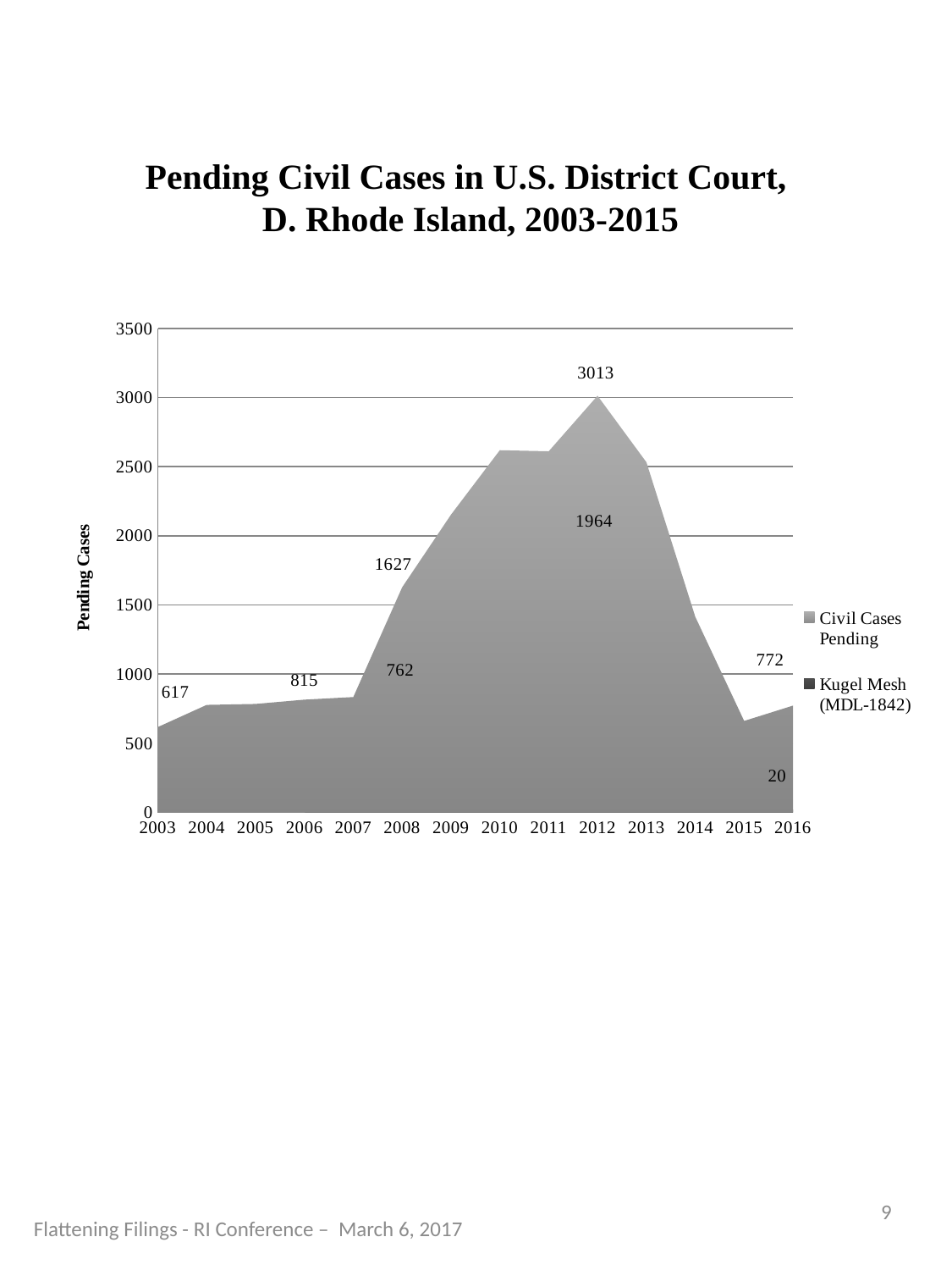
How many series does the legend list? 2 Do Civil Cases Pending rise or fall from 2012 to 2015? Fall What is the difference between Civil Cases Pending in 2012 and in 2008? 1386 What is the value of Civil Cases Pending in 2012? 3013 Is the value for Civil Cases Pending in 2010 greater or less than 2500? greater Which is larger, Civil Cases Pending in 2003 or in 2006? 2006 What is the value of Kugel Mesh (MDL-1842) in 2016? 20 What are the two series named in the legend? Civil Cases Pending; Kugel Mesh (MDL-1842) In which year does Civil Cases Pending reach its highest value? 2012 What is the value of Civil Cases Pending in 2003? 617 How many years are shown along the x axis? 14 What kind of chart is shown on the slide? Area chart